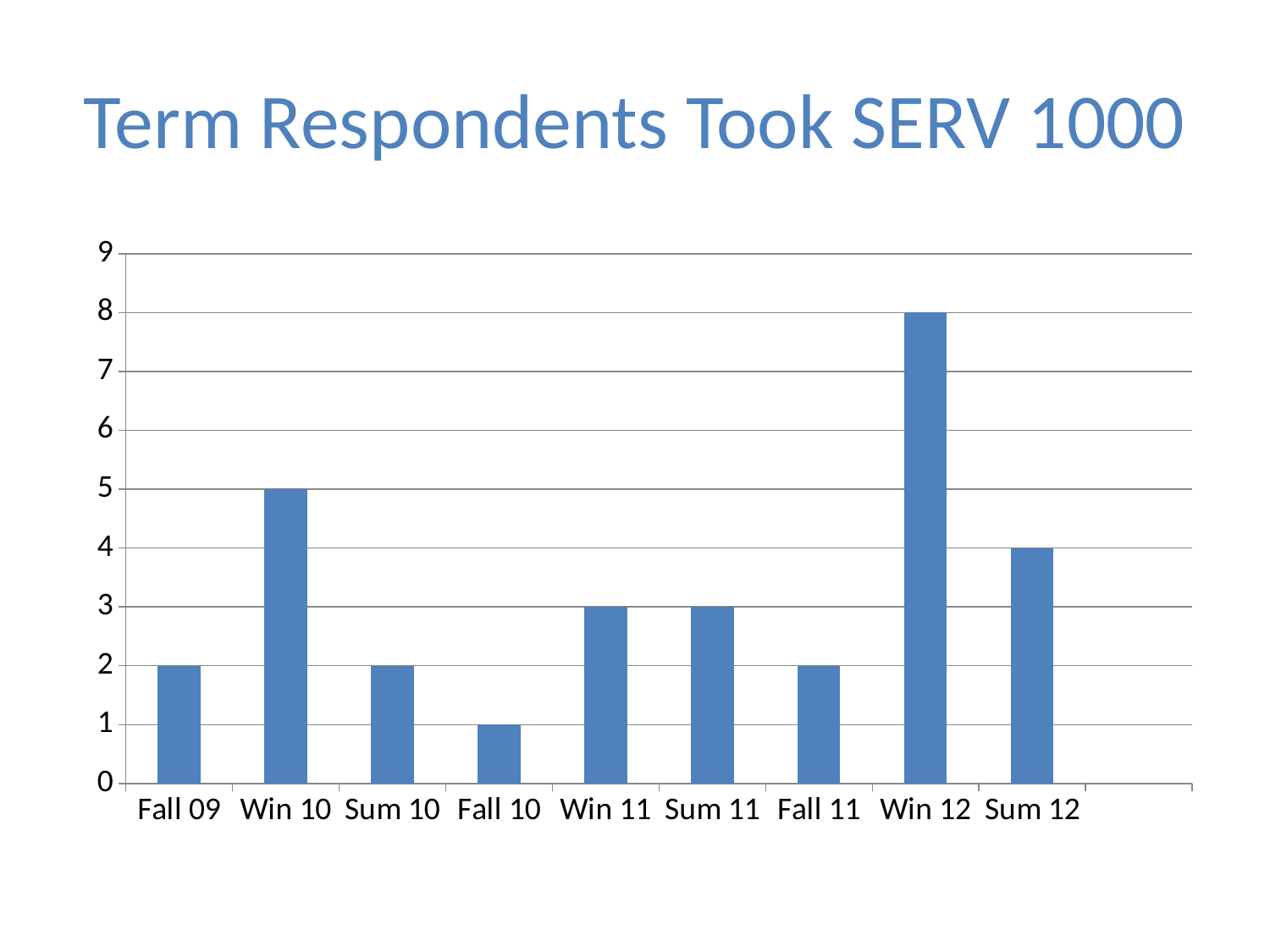
What is the value for Sum 12? 4 Which is larger, the value for Sum 12 or the value for Win 11? Sum 12 What is the difference between the values for Win 12 and Win 10? 3 What kind of chart is shown on the slide? bar chart What is the value for Fall 10? 1 What is the value for Win 10? 5 What is the value for Win 12? 8 Which term has the highest value? Win 12 Is the value for Win 12 greater or less than 6? greater What is the title of the chart? Term Respondents Took SERV 1000 How many terms are shown on the x axis? 9 Which term has the lowest value? Fall 10